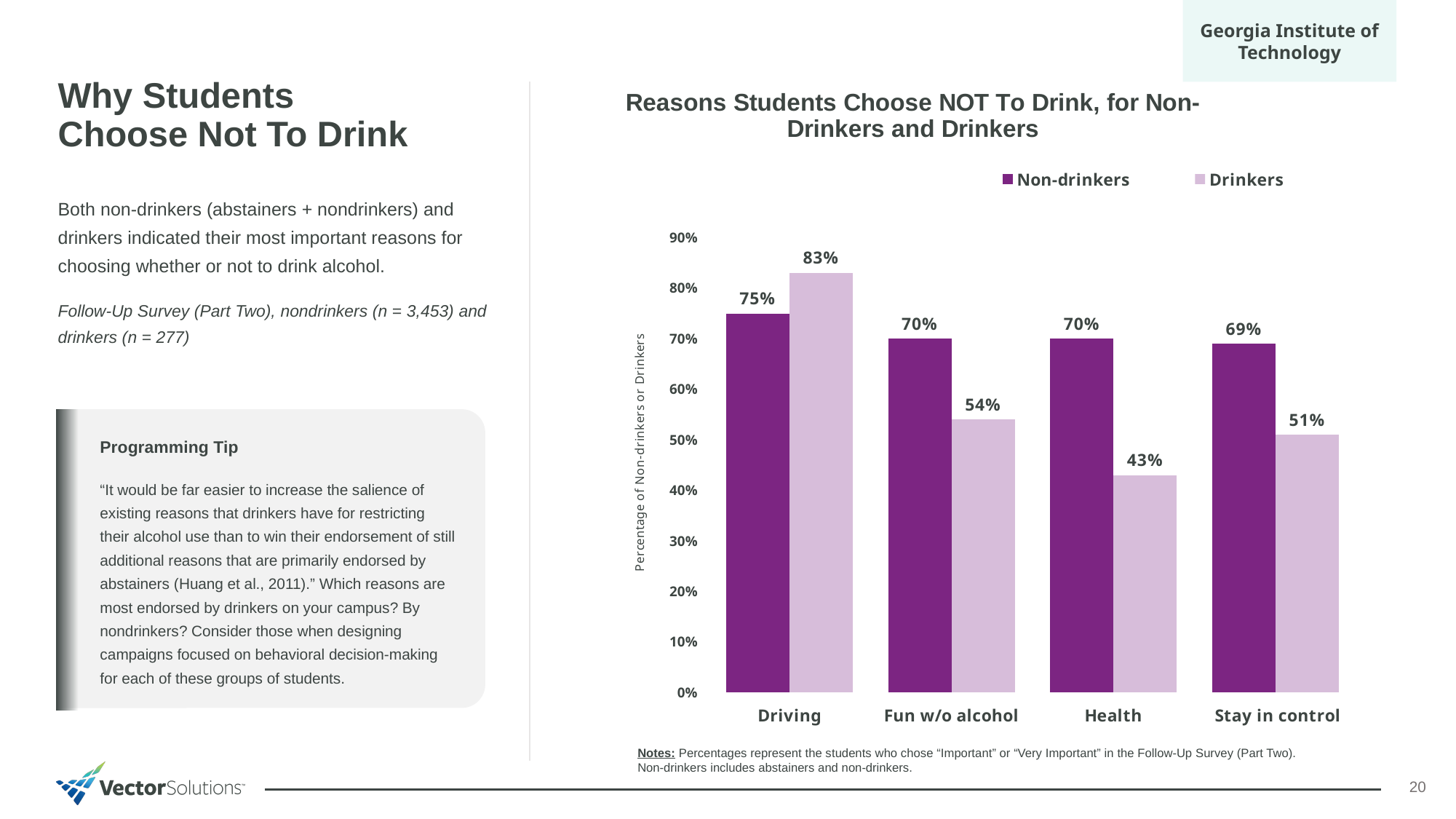
How many series does the legend list? 2 What is the difference between the Non-drinkers and Drinkers values for Health? 27% What type of chart is shown on the slide? Bar chart Which category has the highest value for Drinkers? Driving Which category has the lowest value for Drinkers? Health How many reason categories are shown on the x axis? 4 What is the value for Drinkers in the Stay in control category? 51% What percentage of Non-drinkers chose Driving as a reason not to drink? 75% Which category has the lowest value for Non-drinkers? Stay in control What percentage of Drinkers chose Health as a reason not to drink? 43% What is the difference between the Drinkers and Non-drinkers values for Driving? 8% For Fun w/o alcohol, which group has the larger value, Non-drinkers or Drinkers? Non-drinkers